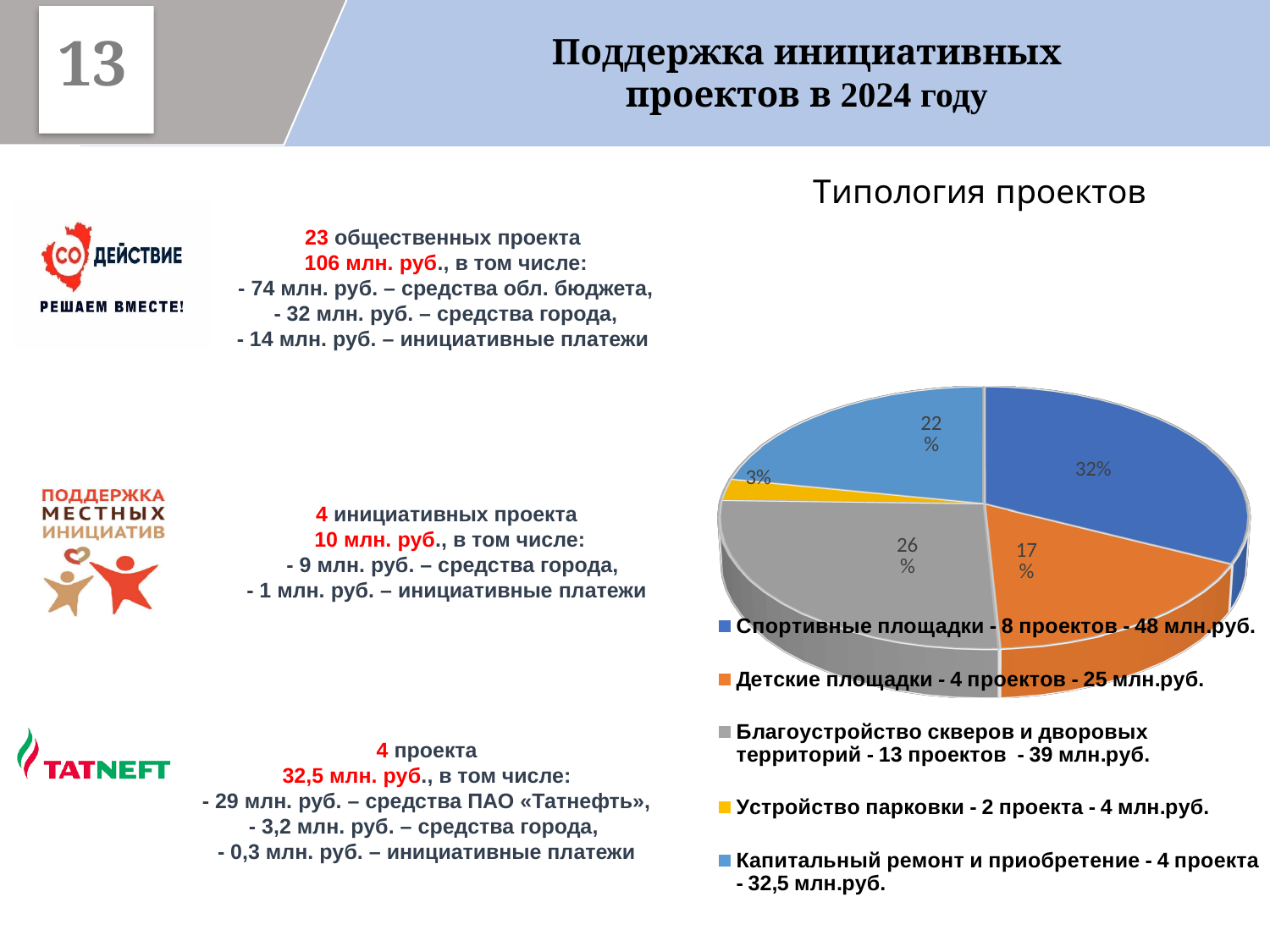
How many slices does the pie chart "Типология проектов" have? 5 In the pie chart "Типология проектов", what share is labelled for "Капитальный ремонт и приобретение"? 22% In the pie chart "Типология проектов", what share is labelled for "Детские площадки"? 17% In the pie chart "Типология проектов", which slice is larger: "Благоустройство скверов и дворовых территорий" or "Капитальный ремонт и приобретение"? Благоустройство скверов и дворовых территорий What is the title shown above the pie chart on the slide? Типология проектов Which category has the largest slice in the pie chart "Типология проектов"? Спортивные площадки Which category has the smallest slice in the pie chart "Типология проектов"? Устройство парковки In the pie chart "Типология проектов", by how many percentage points does the share for "Спортивные площадки" exceed the share for "Детские площадки"? 15 In the pie chart "Типология проектов", what share is labelled for "Спортивные площадки"? 32% In the pie chart "Типология проектов", what share is labelled for "Устройство парковки"? 3% What kind of chart is shown under the heading "Типология проектов"? pie chart In the pie chart "Типология проектов", what share is labelled for "Благоустройство скверов и дворовых территорий"? 26%